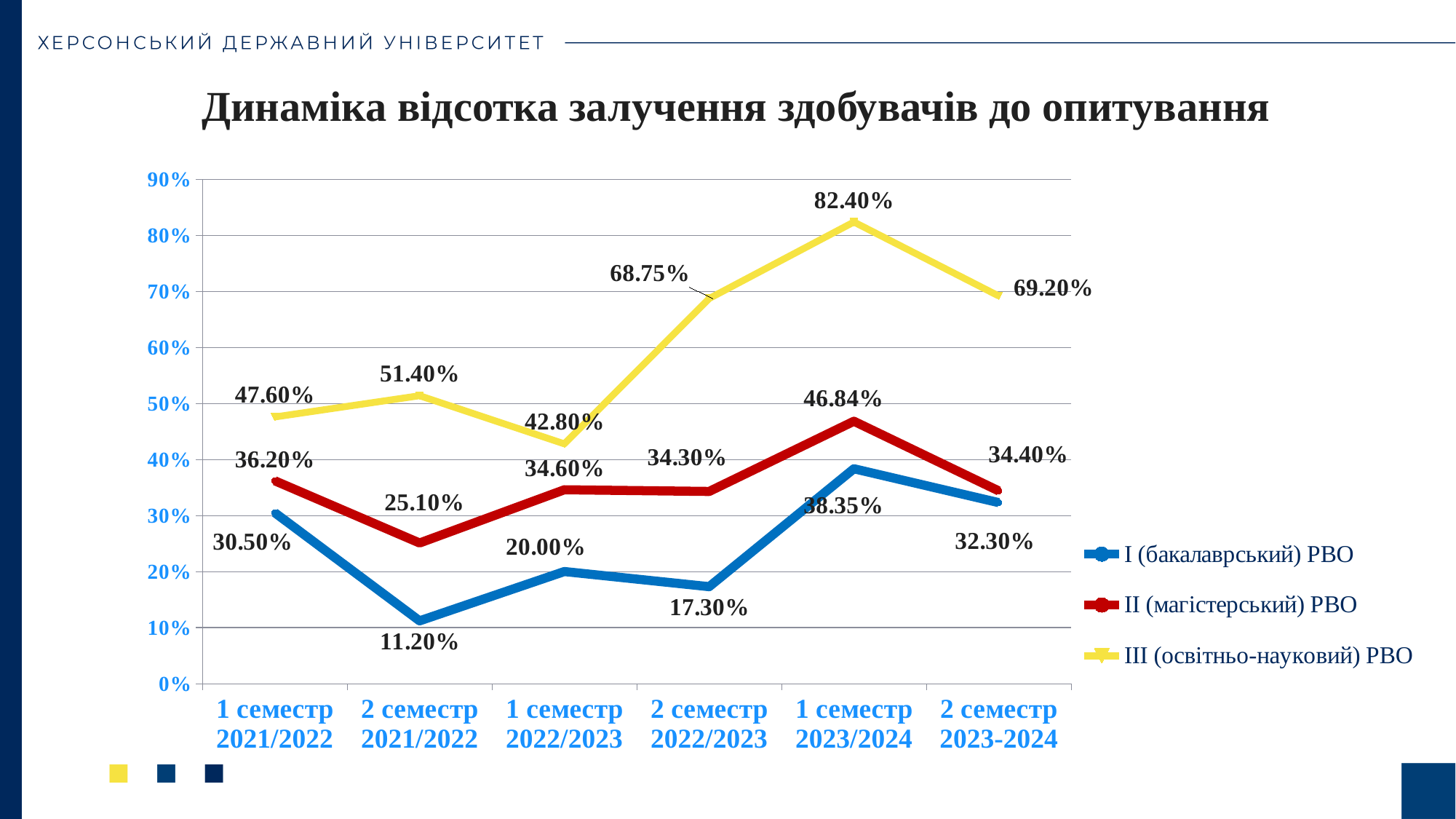
In which semester does III (освітньо-науковий) РВО reach its highest value? 1 семестр 2023/2024 What type of chart is shown on the slide? line chart How many series does the legend list? 3 What colour is the line for III (освітньо-науковий) РВО? yellow What is the value for I (бакалаврський) РВО in 2 семестр 2021/2022? 11.20% What is the difference between III (освітньо-науковий) РВО and I (бакалаврський) РВО in 1 семестр 2023/2024? 44.05% How many semesters are shown on the x axis? 6 In which semester does I (бакалаврський) РВО have its lowest value? 2 семестр 2021/2022 What is the value for II (магістерський) РВО in 2 семестр 2022/2023? 34.30% Which series has the larger value in 2 семестр 2023-2024: I (бакалаврський) РВО or II (магістерський) РВО? II (магістерський) РВО What is the value for III (освітньо-науковий) РВО in 1 семестр 2023/2024? 82.40% Does the value for I (бакалаврський) РВО rise or fall from 1 семестр 2023/2024 to 2 семестр 2023-2024? fall